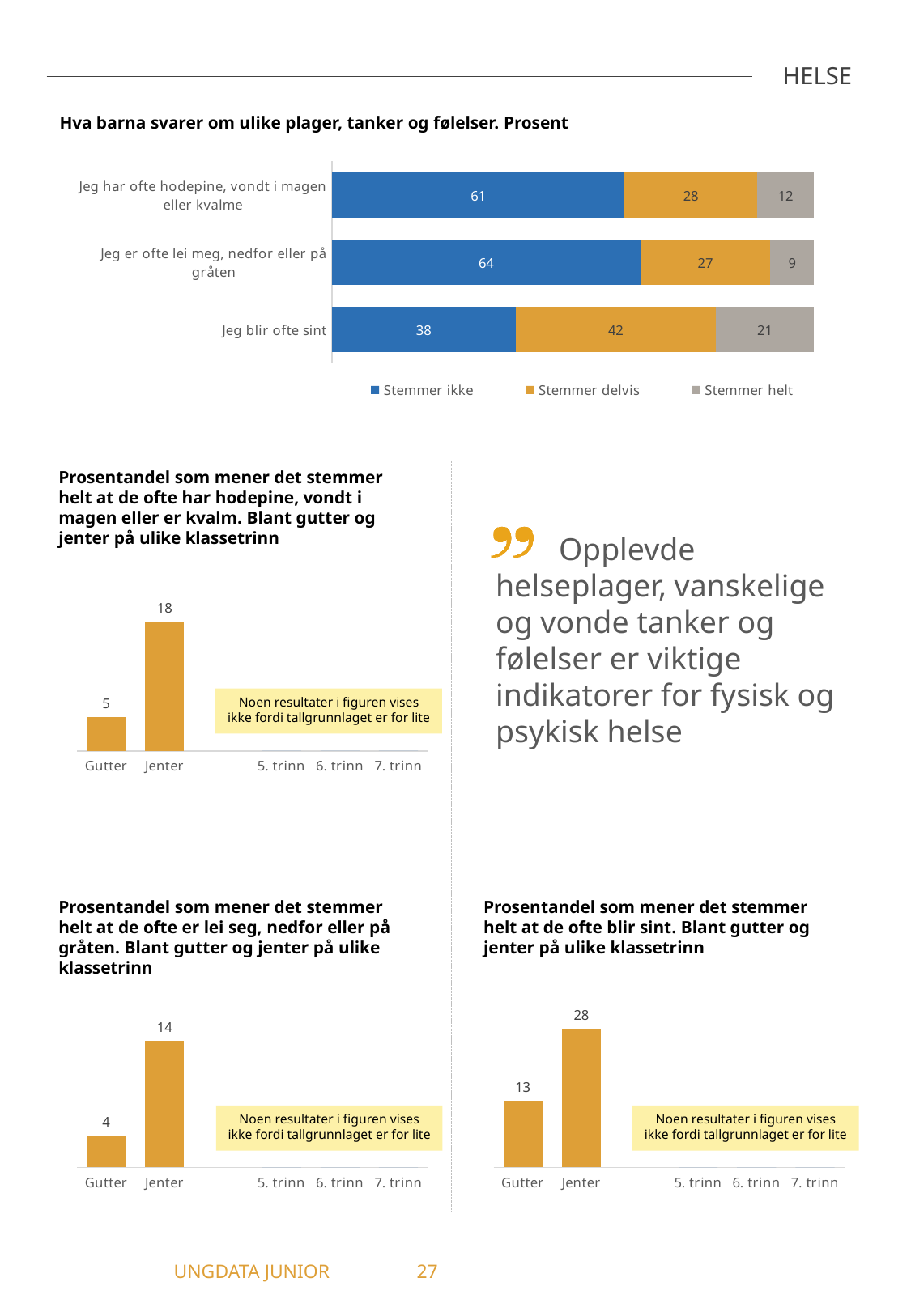
In the chart about "hodepine, vondt i magen eller er kvalm" (middle left), what is the difference between Jenter and Gutter? 13 What kind of chart is the one titled "Hva barna svarer om ulike plager, tanker og følelser. Prosent"? Stacked bar chart In the chart titled "Hva barna svarer om ulike plager, tanker og følelser. Prosent", what is the value for "Stemmer ikke" for "Jeg blir ofte sint"? 38 In the chart about "ofte blir sint" (bottom right), what is the value for Jenter? 28 In the chart about "ofte blir sint" (bottom right), which is larger, Gutter or Jenter? Jenter In the chart about "hodepine, vondt i magen eller er kvalm" (middle left), what is the value for Jenter? 18 In the chart titled "Hva barna svarer om ulike plager, tanker og følelser. Prosent", what is the value for "Stemmer helt" for "Jeg er ofte lei meg, nedfor eller på gråten"? 9 In the chart titled "Hva barna svarer om ulike plager, tanker og følelser. Prosent", what is the difference between the "Stemmer delvis" values for "Jeg blir ofte sint" and "Jeg har ofte hodepine, vondt i magen eller kvalme"? 14 In the chart titled "Hva barna svarer om ulike plager, tanker og følelser. Prosent", which statement has the highest "Stemmer ikke" value? Jeg er ofte lei meg, nedfor eller på gråten In the chart about "lei seg, nedfor eller på gråten" (bottom left), what is the value for Gutter? 4 In the chart titled "Hva barna svarer om ulike plager, tanker og følelser. Prosent", what is the total of the stacked bar for "Jeg har ofte hodepine, vondt i magen eller kvalme"? 101 In the chart titled "Hva barna svarer om ulike plager, tanker og følelser. Prosent", how many series does the legend list? 3